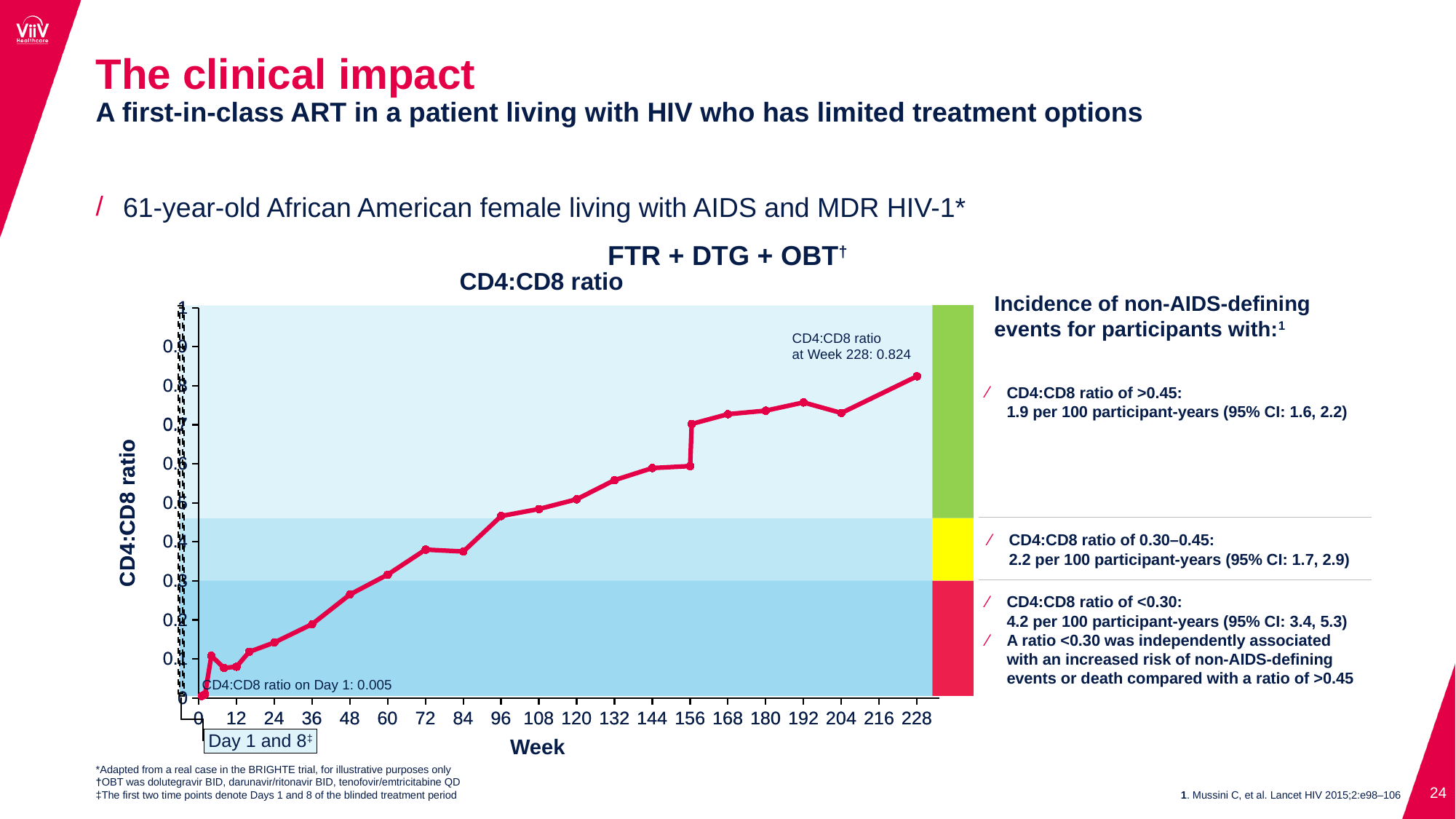
Is the CD4:CD8 ratio at Week 48 greater or less than 0.3? less At which time point is the CD4:CD8 ratio highest? Week 228 Does the CD4:CD8 ratio generally rise or fall over the weeks shown? Rise What is the CD4:CD8 ratio on Day 1? 0.005 What is the CD4:CD8 ratio at Week 228? 0.824 Which is larger, the CD4:CD8 ratio at Week 96 or at Week 48? Week 96 What is the label on the x axis of the chart? Week Is the CD4:CD8 ratio at Week 192 greater or less than 0.7? greater At which time point is the CD4:CD8 ratio lowest? Day 1 What kind of chart is shown on the slide? Line chart What is the difference between the CD4:CD8 ratio at Week 228 and on Day 1? 0.819 What is the title of the chart? CD4:CD8 ratio